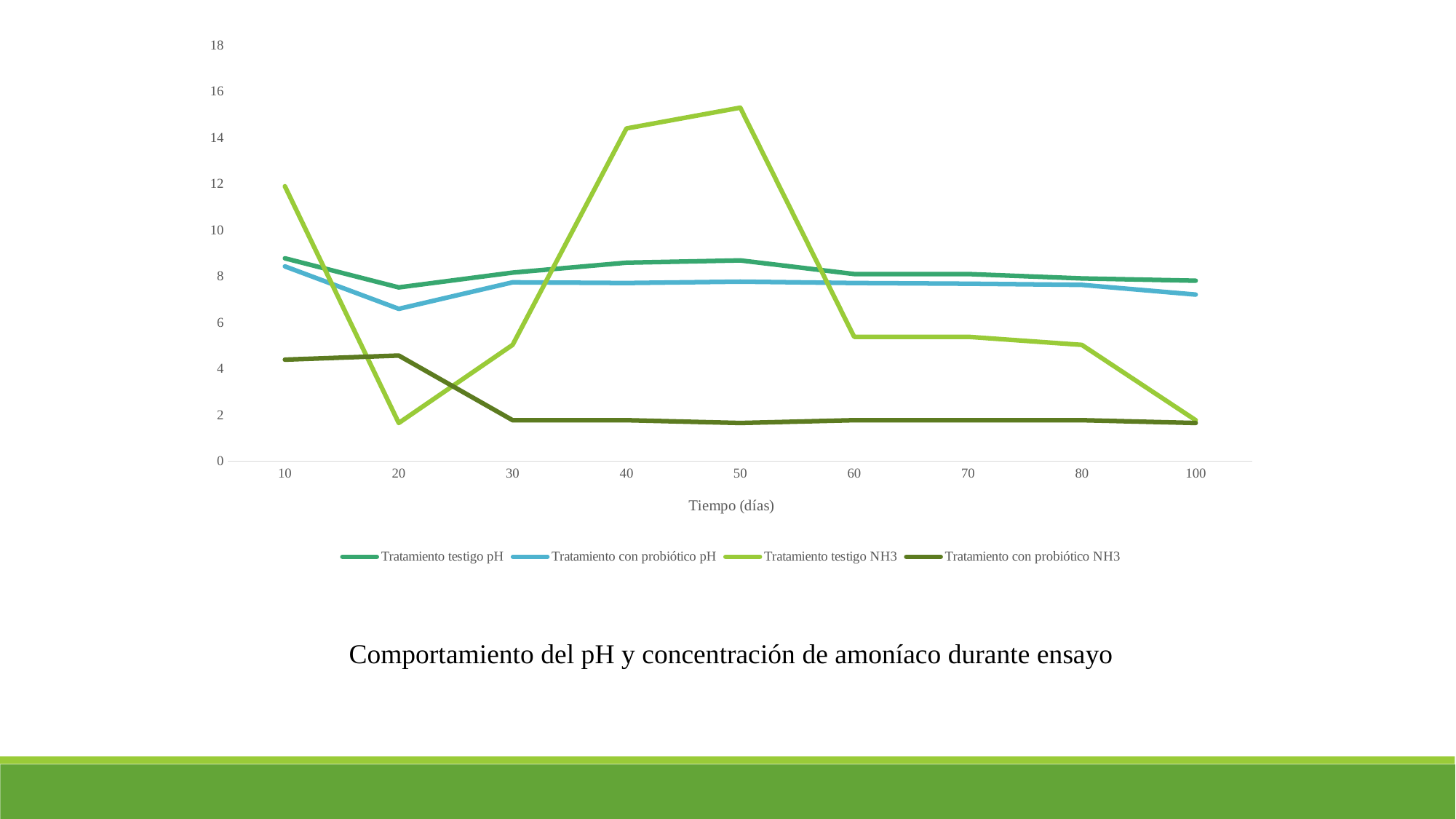
Is the value of Tratamiento con probiótico NH3 at day 50 greater or less than 2? less At which time (days) does the Tratamiento testigo NH3 series reach its highest value? 50 Does the Tratamiento testigo NH3 series rise or fall between day 50 and day 100? fall How many series does the legend list? 4 What caption is shown below the chart? Comportamiento del pH y concentración de amoníaco durante ensayo Is the value of Tratamiento testigo NH3 at day 50 greater or less than 14? greater What kind of chart is shown on the slide? line chart At day 40, which series has the larger value: Tratamiento testigo NH3 or Tratamiento con probiótico NH3? Tratamiento testigo NH3 What is the title of the x axis? Tiempo (días) At day 20, which series has the larger value: Tratamiento testigo pH or Tratamiento con probiótico pH? Tratamiento testigo pH Is the value of Tratamiento testigo NH3 at day 10 greater or less than 10? greater How many time points are plotted along the x axis? 9